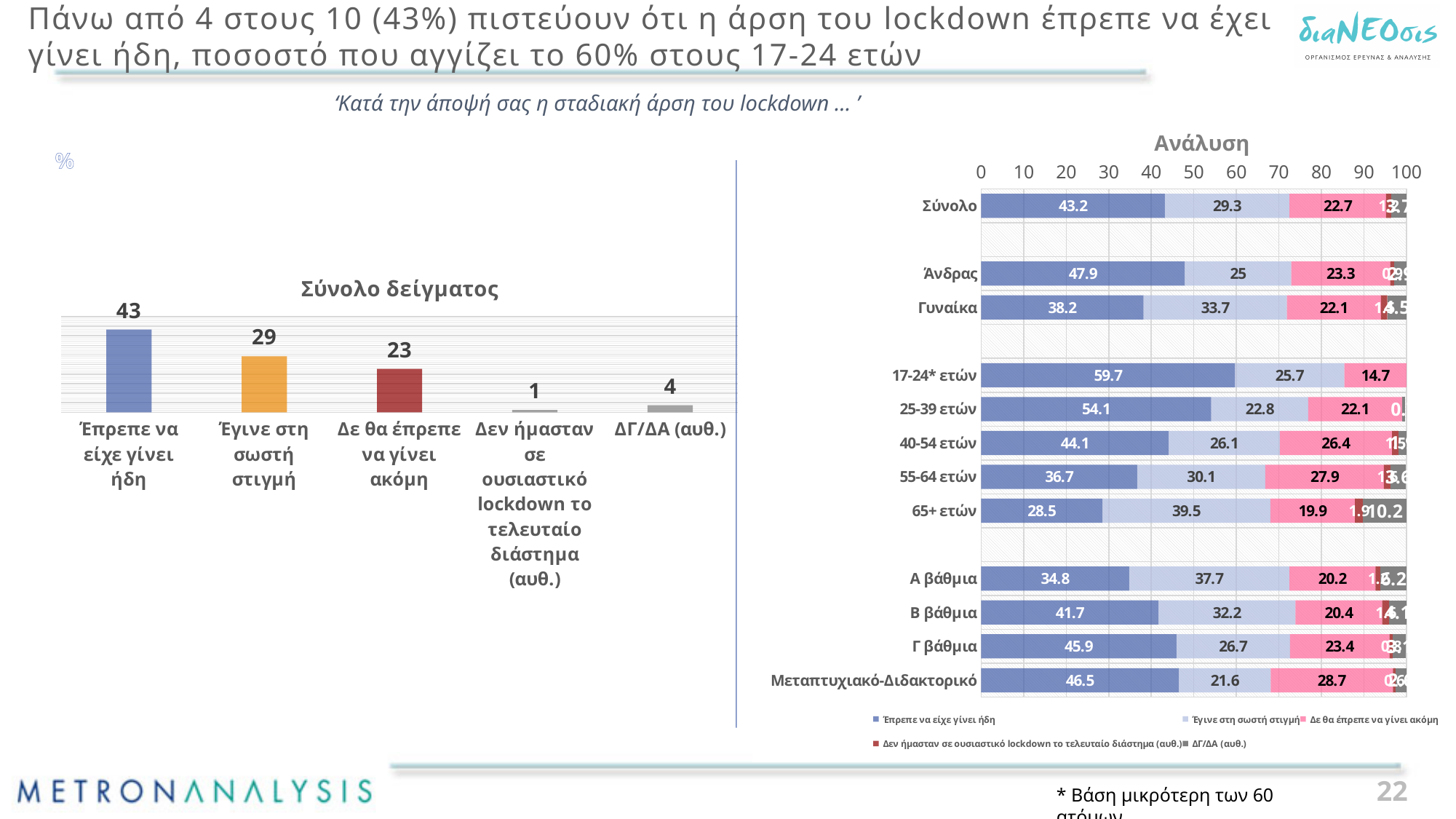
In the left chart titled 'Σύνολο δείγματος', which category has the lowest value? Δεν ήμασταν σε ουσιαστικό lockdown το τελευταίο διάστημα (αυθ.) In the right chart titled 'Ανάλυση', which age group has the highest value for 'Έπρεπε να είχε γίνει ήδη'? 17-24* ετών In the right chart titled 'Ανάλυση', which has the larger value for 'Έπρεπε να είχε γίνει ήδη', 'Άνδρας' or 'Γυναίκα'? Άνδρας In the right chart titled 'Ανάλυση', what is the value of 'Έγινε στη σωστή στιγμή' for '65+ ετών'? 39.5 In the right chart titled 'Ανάλυση', what is the value of 'Έπρεπε να είχε γίνει ήδη' for '17-24* ετών'? 59.7 In the left chart titled 'Σύνολο δείγματος', how many categories are shown? 5 In the left chart titled 'Σύνολο δείγματος', which category has the highest value? Έπρεπε να είχε γίνει ήδη In the right chart titled 'Ανάλυση', how many series does the legend list? 5 In the left chart titled 'Σύνολο δείγματος', what is the value for 'Έπρεπε να είχε γίνει ήδη'? 43 In the left chart titled 'Σύνολο δείγματος', what is the difference between 'Έπρεπε να είχε γίνει ήδη' and 'Έγινε στη σωστή στιγμή'? 14 What kind of chart is the left chart titled 'Σύνολο δείγματος'? Bar chart In the right chart titled 'Ανάλυση', what is the value of 'Δε θα έπρεπε να γίνει ακόμη' for 'Μεταπτυχιακό-Διδακτορικό'? 28.7